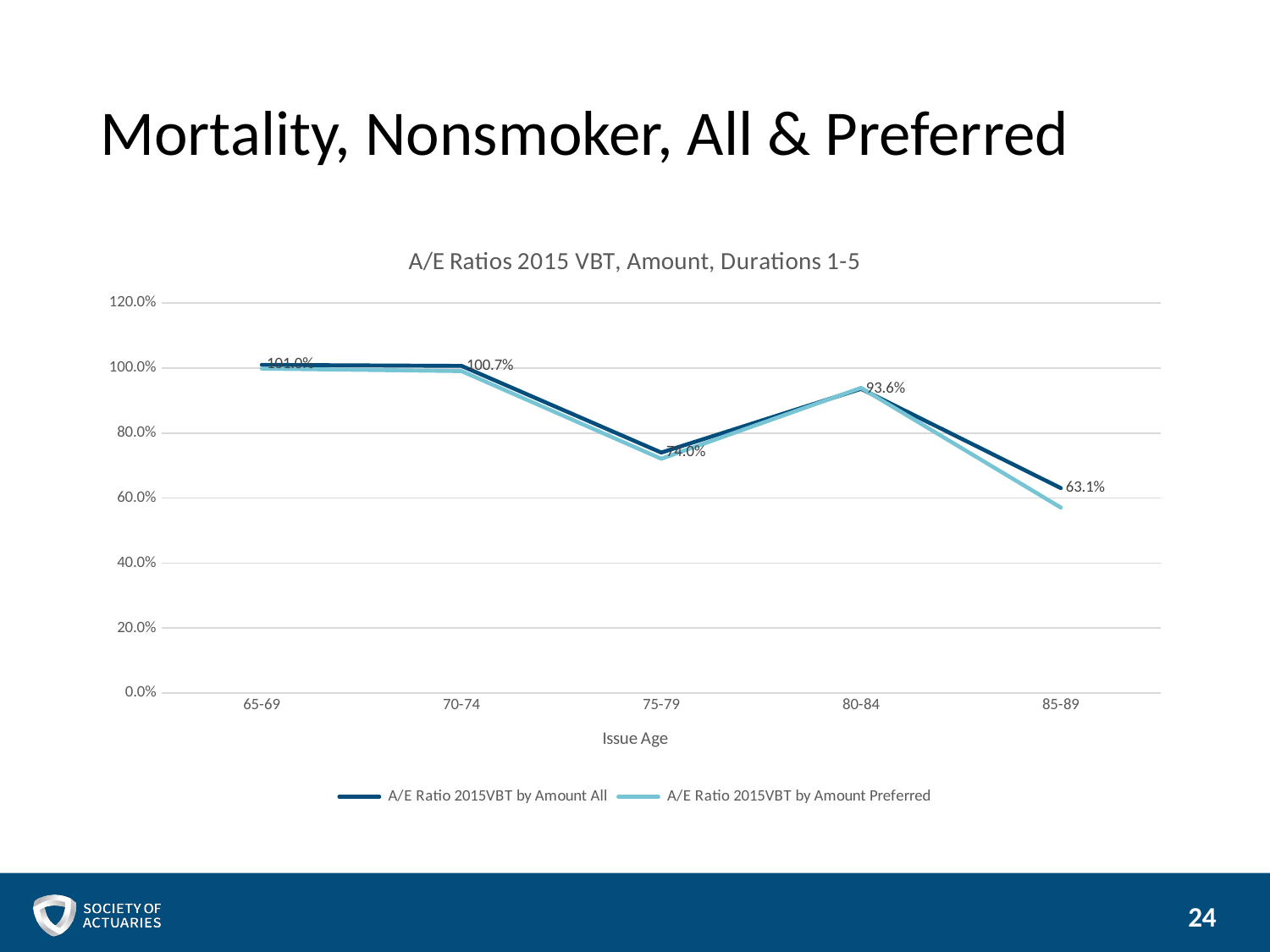
Is the A/E Ratio 2015VBT by Amount Preferred for issue age 85-89 greater or less than 60.0%? less What is the difference between the A/E Ratio 2015VBT by Amount All for issue age 80-84 and for issue age 85-89? 30.5 percentage points What is the A/E Ratio 2015VBT by Amount All for issue age 70-74? 100.7% What is the title of the chart? A/E Ratios 2015 VBT, Amount, Durations 1-5 How many issue age groups are plotted on the x axis? 5 Which issue age group has the lowest A/E Ratio 2015VBT by Amount All? 85-89 What kind of chart is shown on the slide? line chart Which has the larger A/E Ratio 2015VBT by Amount All: issue age 70-74 or issue age 75-79? 70-74 What is the A/E Ratio 2015VBT by Amount All for issue age 75-79? 74.0% What is the A/E Ratio 2015VBT by Amount All for issue age 80-84? 93.6% What is the A/E Ratio 2015VBT by Amount All for issue age 85-89? 63.1% How many series does the legend list? 2